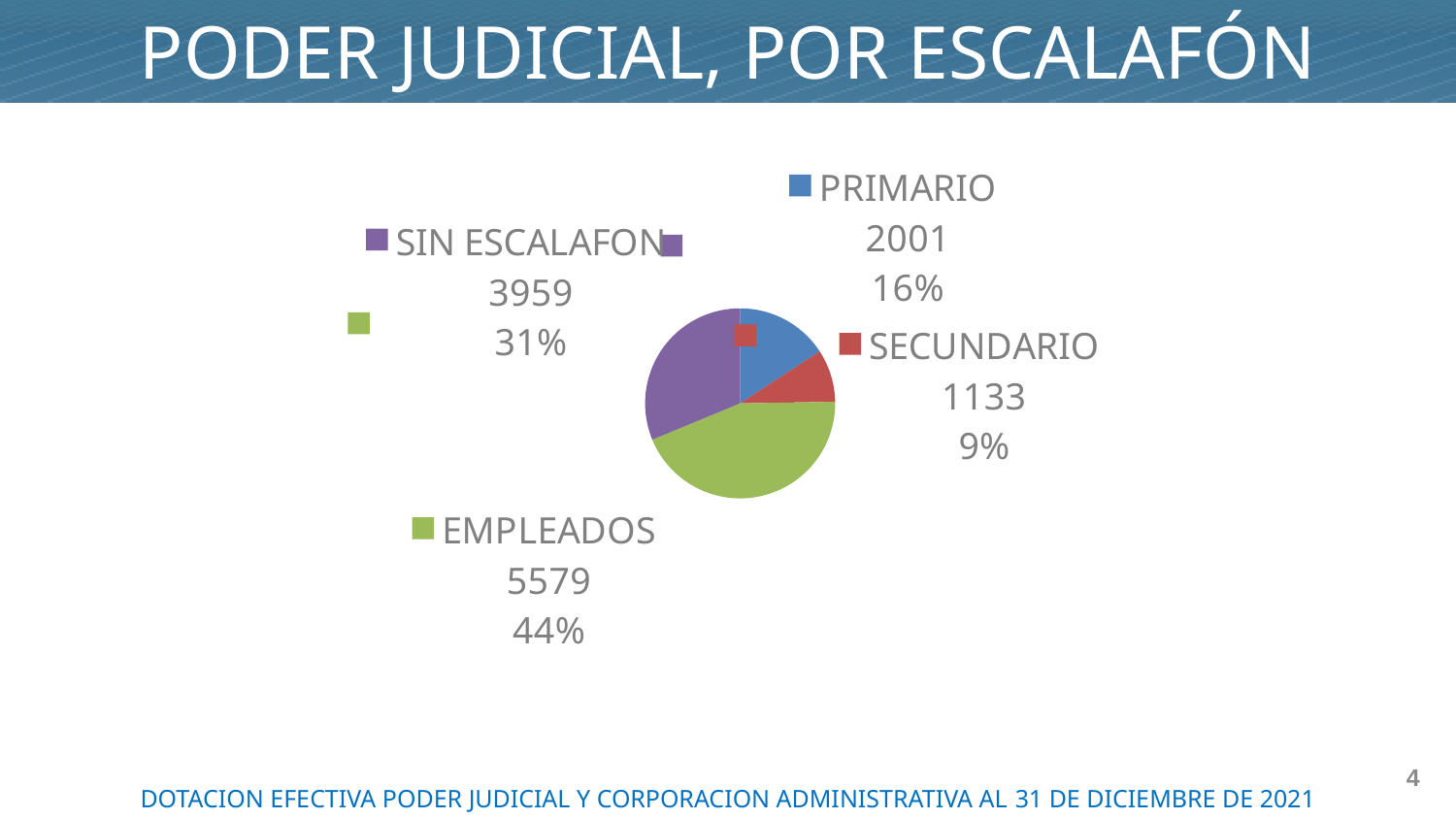
What kind of chart is shown on the slide? pie chart What is the value for SECUNDARIO? 1133 Which is larger, the value for PRIMARIO or the value for SECUNDARIO? PRIMARIO What is the value for EMPLEADOS? 5579 Which category has the smallest slice? SECUNDARIO What is the value for SIN ESCALAFON? 3959 What share of the pie does EMPLEADOS represent? 44% How many categories does the pie chart show? 4 Which category has the largest slice? EMPLEADOS What share of the pie does SIN ESCALAFON represent? 31% What is the value for PRIMARIO? 2001 What is the difference between the values for EMPLEADOS and SIN ESCALAFON? 1620